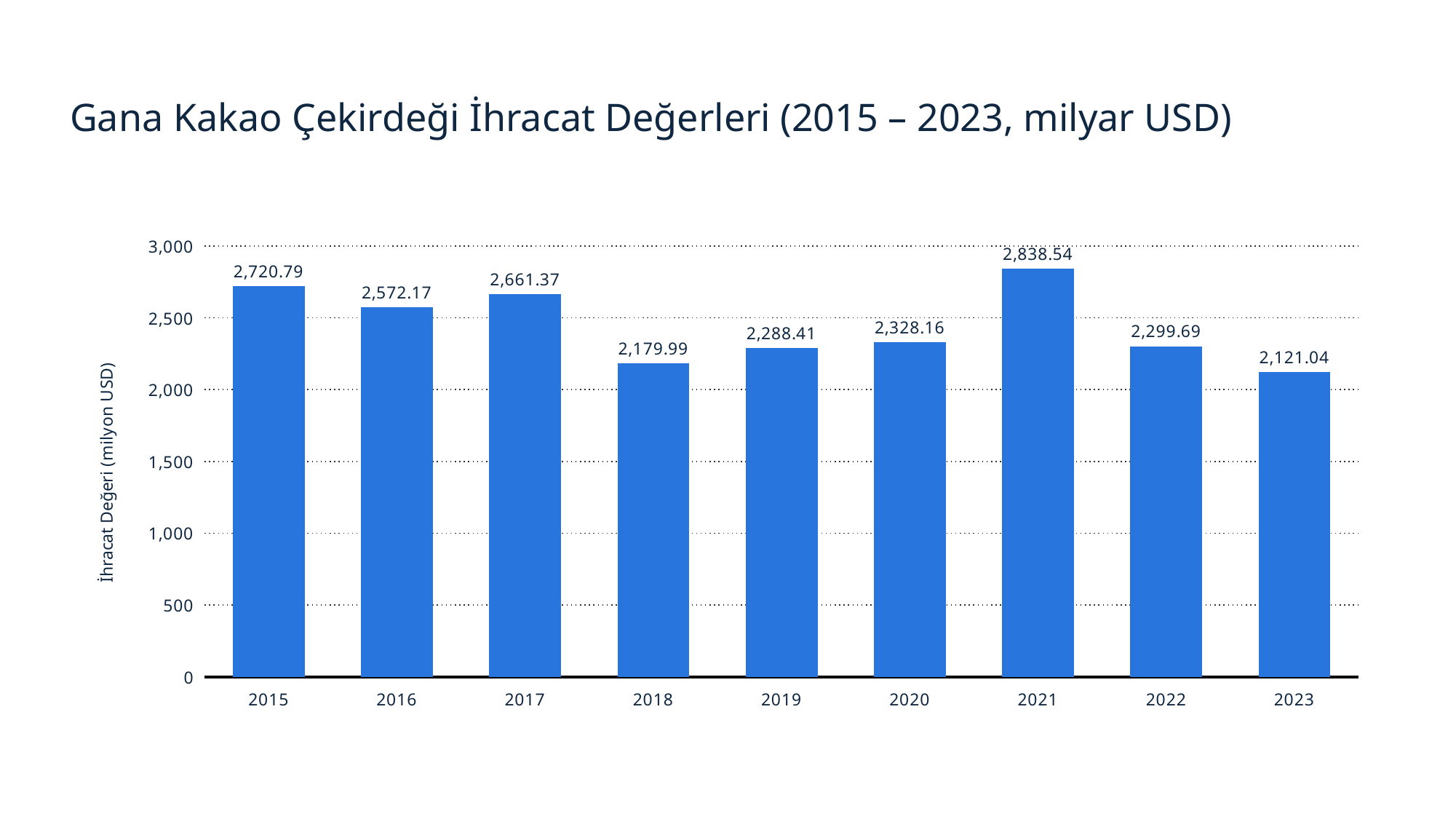
What is the export value shown for 2015? 2,720.79 Which year has a larger export value, 2017 or 2018? 2017 What is the label of the vertical axis? İhracat Değeri (milyon USD) What is the difference between the export values for 2015 and 2016? 148.62 Which year has the lowest export value? 2023 Is the value for 2018 greater or less than 2,500? less Which year has the highest export value? 2021 How many years are shown on the x axis? 9 What is the export value shown for 2018? 2,179.99 What is the difference between the export values for 2021 and 2023? 717.50 What kind of chart is shown on the slide? bar chart What is the export value shown for 2021? 2,838.54